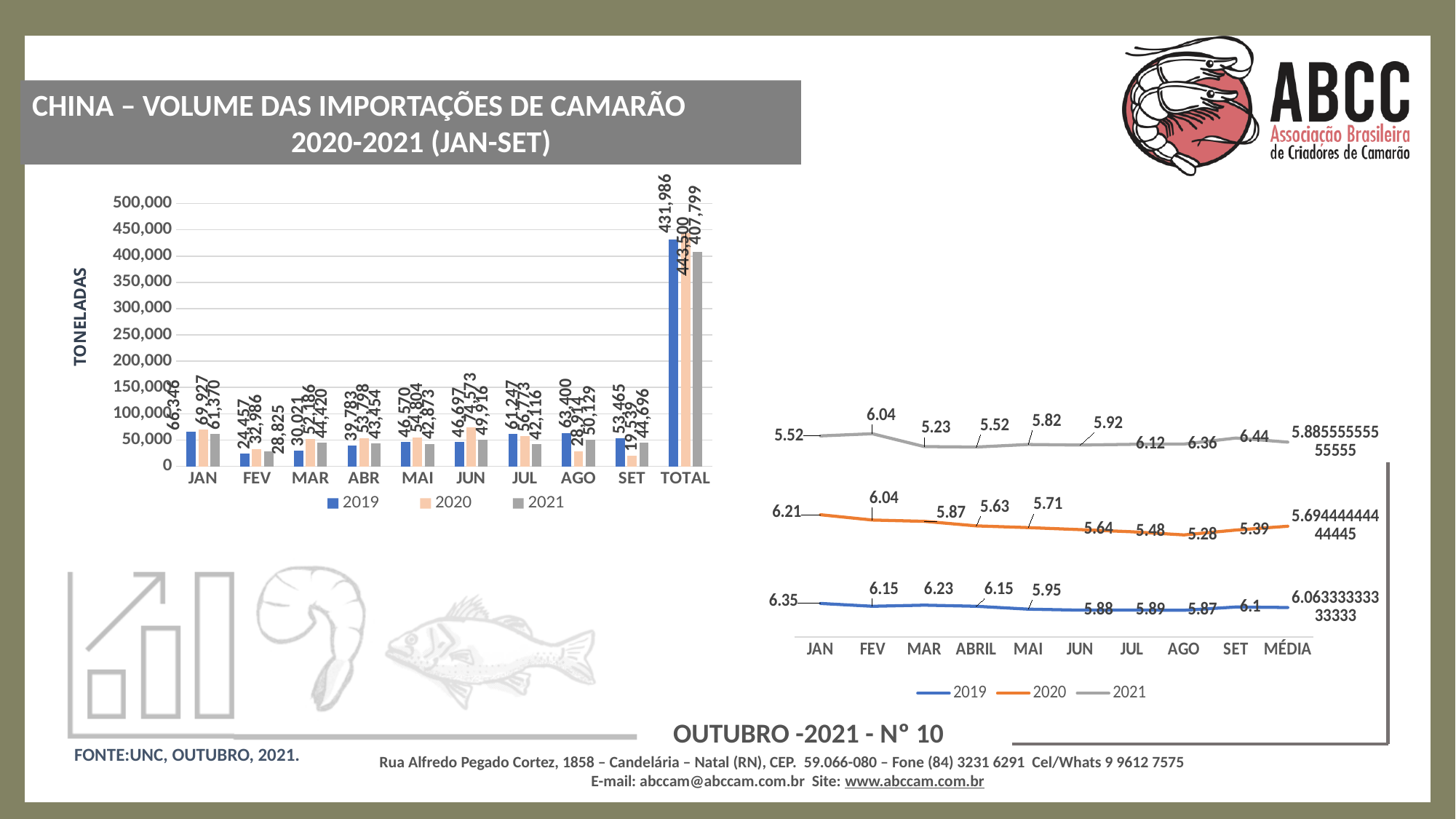
In the line chart on the right, what is the 2021 value for SET? 6.44 In the line chart on the right, which month has the lowest 2021 value? MAR In the bar chart on the left, how many categories are shown on the x axis? 10 In the bar chart on the left, which year has the highest TOTAL? 2020 In the bar chart on the left, what is the difference between the 2019 and 2020 values for SET? 33,926 In the bar chart on the left, what is the TOTAL value for 2021? 407,799 In the line chart on the right, how many series does the legend list? 3 In the bar chart on the left, which is larger for AGO: the 2019 value or the 2020 value? 2019 In the line chart on the right, what is the 2020 value for AGO? 5.28 What type of chart is the chart on the left? Bar chart In the bar chart on the left, which month has the lowest 2019 value? FEV In the bar chart on the left, what is the 2020 value for JUN? 74,573